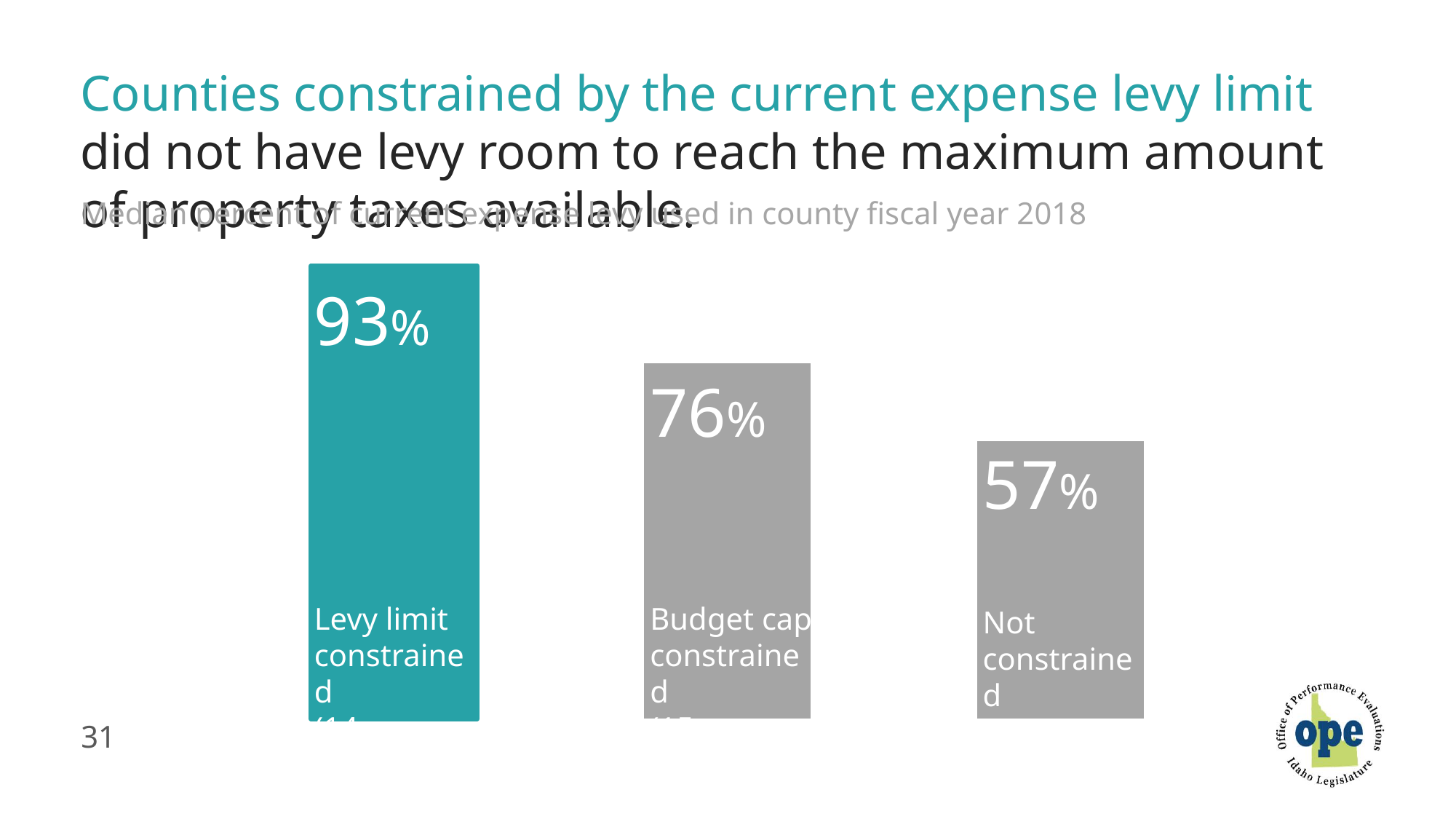
Which is larger: the value for budget cap constrained or not constrained counties? Budget cap constrained What is the difference in percentage points between levy limit constrained and not constrained counties? 36 Do the values rise or fall from left to right across the categories? Fall Which bar is highlighted in teal rather than grey? Levy limit constrained What is the median percent of current expense levy used for not constrained counties? 57% What is the median percent of current expense levy used for levy limit constrained counties? 93% Which category has the highest median percent of current expense levy used? Levy limit constrained Which category has the lowest median percent of current expense levy used? Not constrained How many categories are shown in the chart? 3 What kind of chart is shown on the slide? Bar chart What is the median percent of current expense levy used for budget cap constrained counties? 76% What is the difference in percentage points between levy limit constrained and budget cap constrained counties? 17